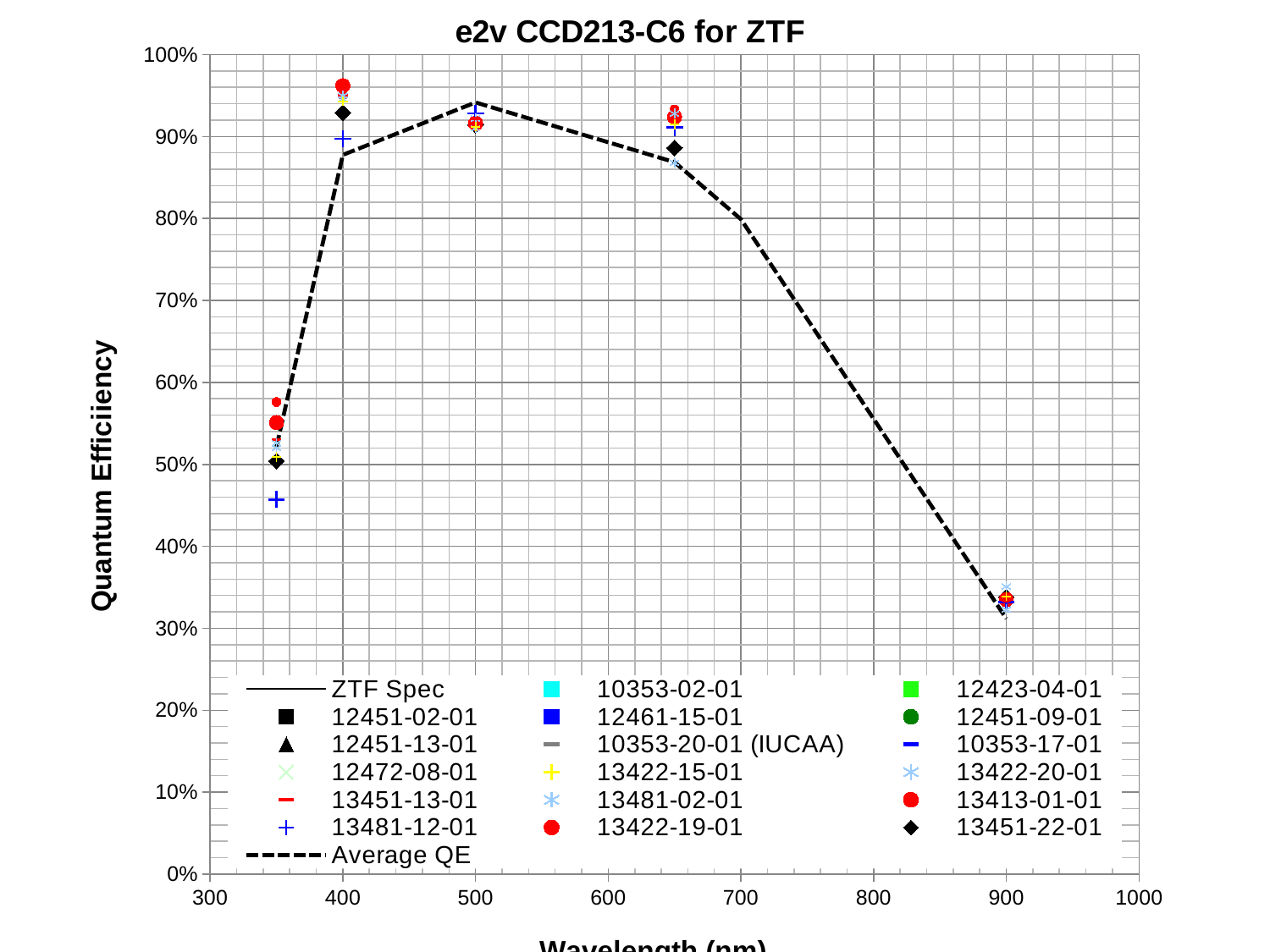
Is the Average QE at 900 nm greater or less than 40%? less What is the title of the chart? e2v CCD213-C6 for ZTF What kind of chart is shown on the slide? scatter chart What is the label of the y axis? Quantum Efficiiency Is the Average QE at 350 nm greater or less than 60%? less At how many wavelength points is the Average QE plotted? 6 Which is larger, the Average QE at 350 nm or at 900 nm? 350 nm At which wavelength is the Average QE lowest? 900 nm Does the Average QE rise or fall between 500 nm and 900 nm? fall Is the Average QE at 500 nm greater or less than 90%? greater How many entries does the chart legend list? 19 At which wavelength is the Average QE highest? 500 nm